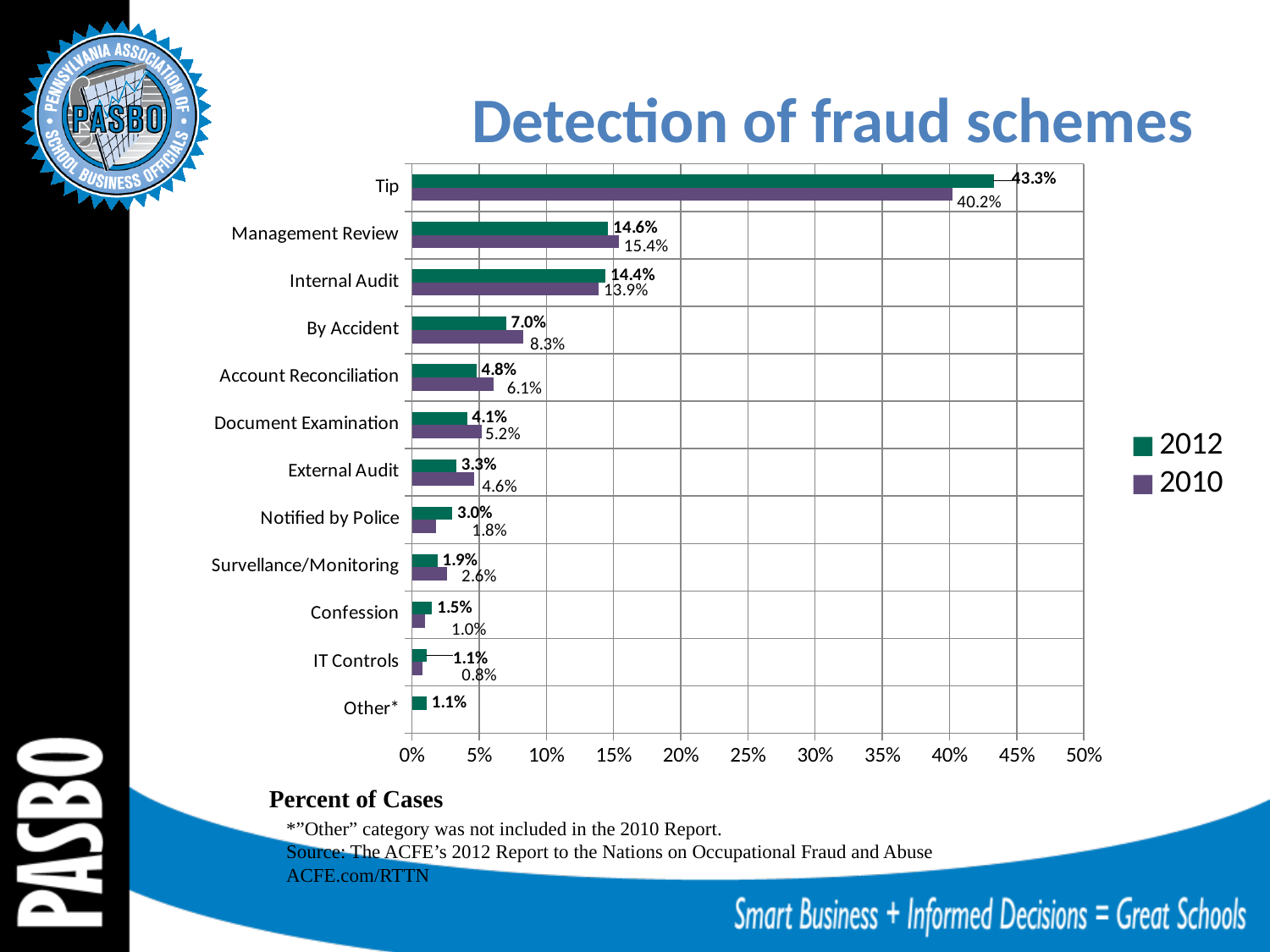
How many detection method categories are shown on the chart? 12 What kind of chart is shown on the slide? Bar chart What is the 2010 value for Management Review? 15.4% What is the title of the chart? Detection of fraud schemes What is the 2012 value for Tip? 43.3% How many series does the legend list? 2 What is the difference between the 2012 and 2010 values for Tip? 3.1% What is the 2012 value for By Accident? 7.0% Which is larger for Internal Audit, the 2012 value or the 2010 value? 2012 Which detection method has the highest 2012 value? Tip Which detection method has the lowest 2010 value? IT Controls Which is larger for Notified by Police, the 2012 value or the 2010 value? 2012